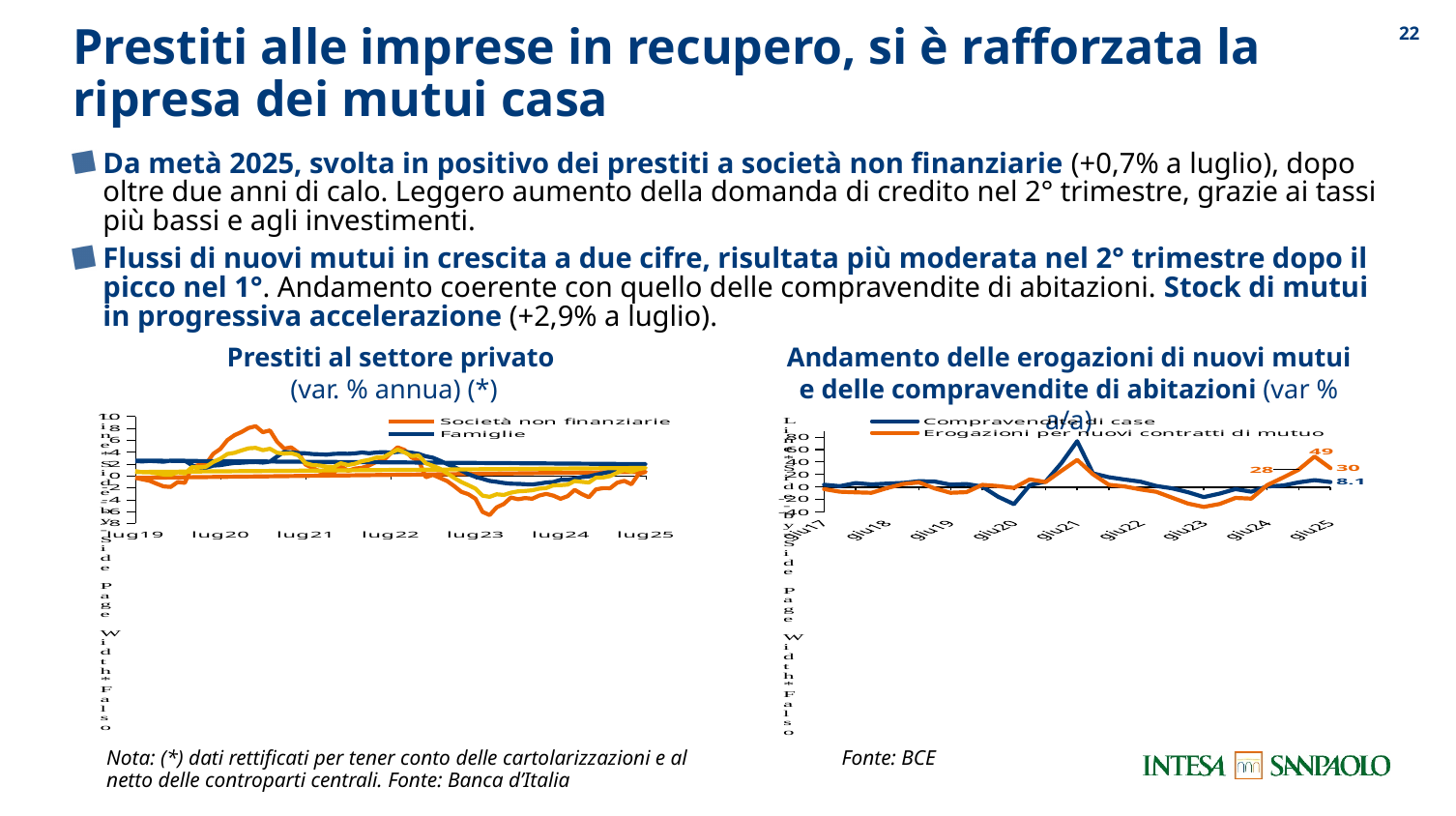
In the left chart 'Prestiti al settore privato', how many labelled ticks are on the x axis? 7 In the right chart on mortgages and house sales, how many series does the legend list? 2 In the left chart 'Prestiti al settore privato', how many series does the legend list? 2 In the left chart 'Prestiti al settore privato', which two series are shown in the legend? Società non finanziarie and Famiglie In the right chart on mortgages and house sales, what is the difference between the labelled peak of 49 and the latest value of 30 for Erogazioni per nuovi contratti di mutuo? 19 What kind of chart is the left chart titled 'Prestiti al settore privato'? line chart In the left chart 'Prestiti al settore privato', is the peak value of Società non finanziarie around lug20–lug21 greater or less than 4? greater In the right chart on mortgages and house sales, what is the highest labelled value for Erogazioni per nuovi contratti di mutuo? 49 In the right chart on mortgages and house sales, what is the latest labelled value for Erogazioni per nuovi contratti di mutuo? 30 In the left chart 'Prestiti al settore privato', does the Società non finanziarie series rise or fall between lug22 and lug23? fall In the right chart on mortgages and house sales, what is the latest labelled value for Compravendite di case? 8.1 In the left chart 'Prestiti al settore privato', is the value of Società non finanziarie around lug23 greater or less than 0? less